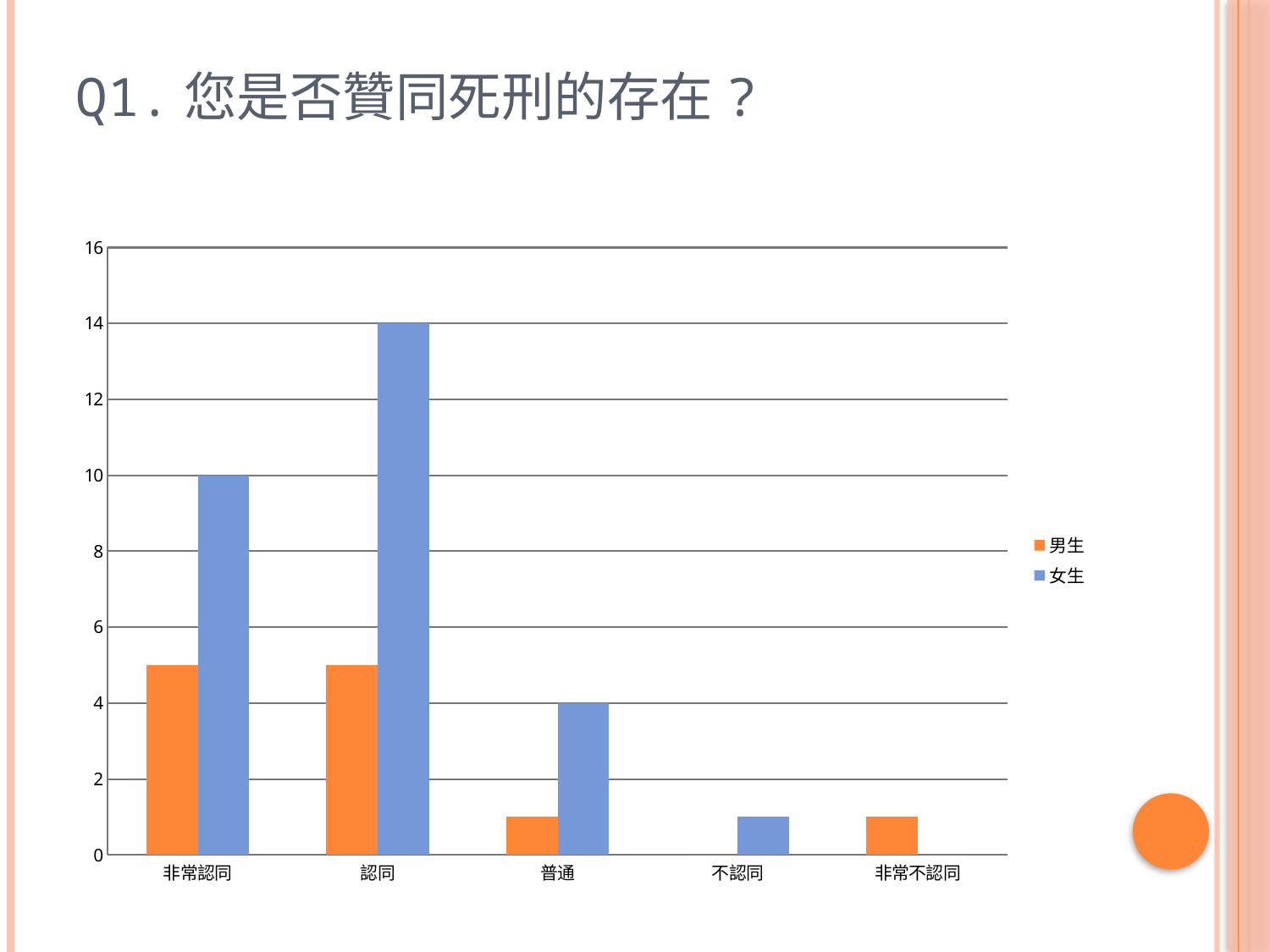
Which category has the highest value for 女生? 認同 How many series does the legend list? 2 What is the value for 女生 in the 非常認同 category? 10 Which colour represents the 男生 series? orange Is the value for 男生 in the 非常認同 category greater or less than 4? greater How many categories are shown on the x axis? 5 What is the difference between the 女生 values for 認同 and 非常認同? 4 Is the value for 男生 in the 普通 category greater or less than 2? less What is the value for 女生 in the 認同 category? 14 In the 認同 category, which series has the larger value, 男生 or 女生? 女生 What is the value for 女生 in the 普通 category? 4 What type of chart is shown on the slide? bar chart